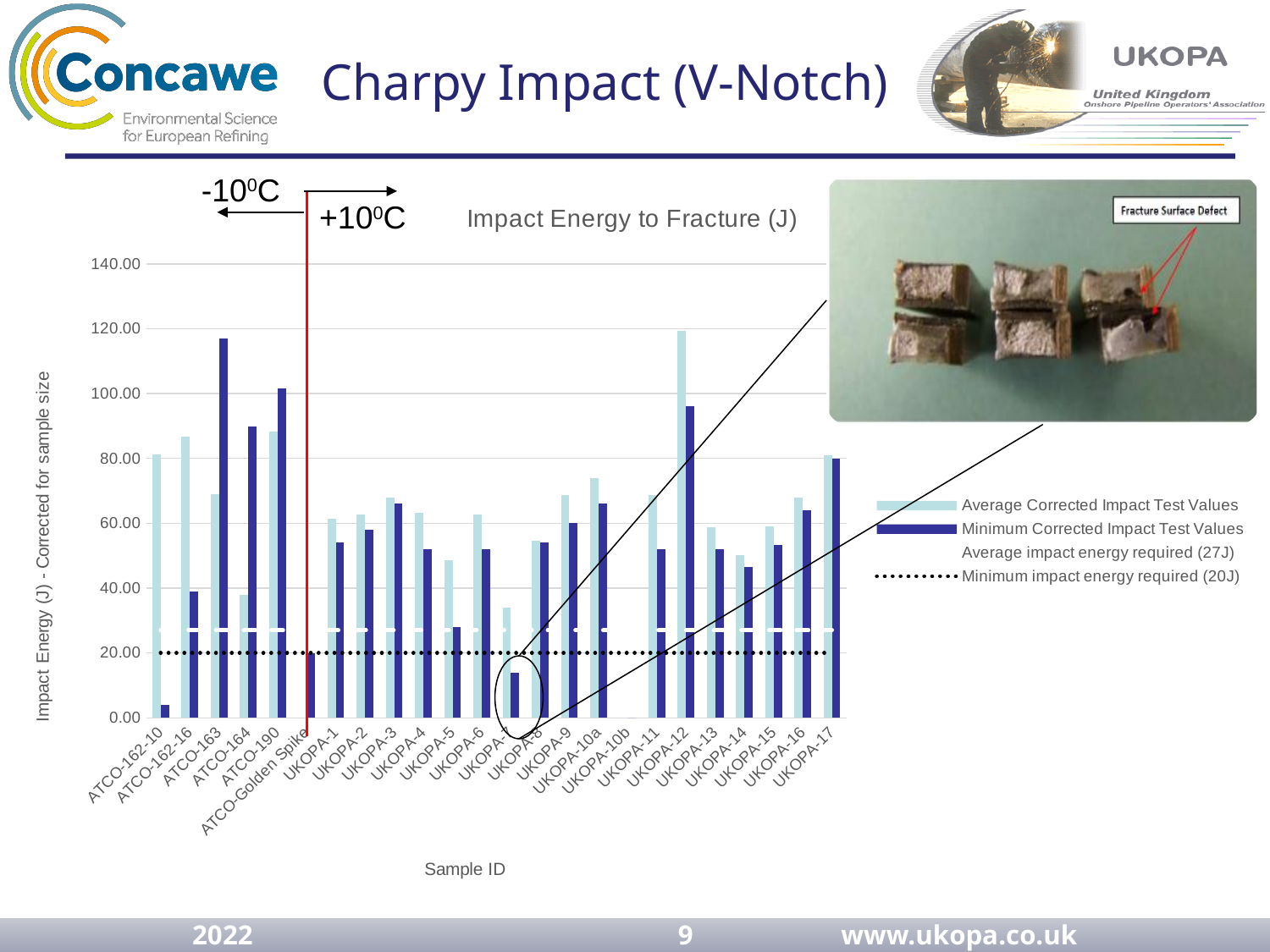
For ATCO-164, which is larger: the Average Corrected Impact Test Value or the Minimum Corrected Impact Test Value? Minimum Corrected Impact Test Value Which sample has the highest Minimum Corrected Impact Test Value? ATCO-163 What is the label of the x axis of the chart? Sample ID What type of chart is shown on the slide? bar chart How many entries does the chart legend list? 4 Is the Minimum Corrected Impact Test Value for ATCO-163 greater or less than 100.00? greater Is the Minimum Corrected Impact Test Value for ATCO-162-10 greater or less than 20.00? less What is the title of the chart? Impact Energy to Fracture (J) According to the legend, what is the minimum impact energy required? 20J Is the Average Corrected Impact Test Value for UKOPA-12 greater or less than 100.00? greater According to the legend, what is the average impact energy required? 27J